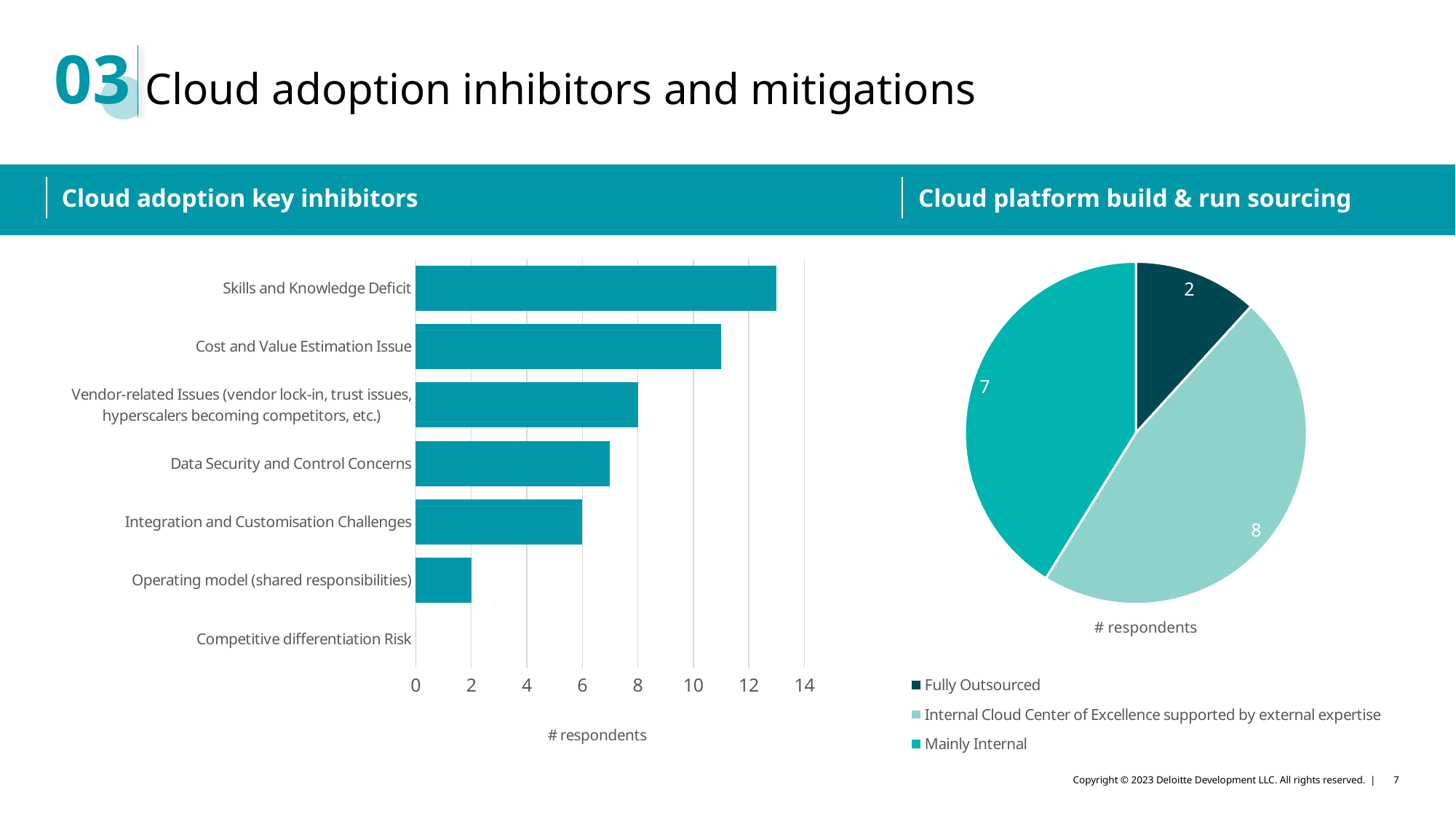
On the Cloud platform build & run sourcing pie chart, how many respondents chose Fully Outsourced? 2 On the Cloud adoption key inhibitors chart, how many respondents cited Operating model (shared responsibilities)? 2 On the Cloud adoption key inhibitors chart, which inhibitor has the highest number of respondents? Skills and Knowledge Deficit On the Cloud adoption key inhibitors chart, how many respondents cited Vendor-related Issues? 8 What type of chart is the Cloud adoption key inhibitors chart? Bar chart On the Cloud platform build & run sourcing pie chart, what is the difference in respondents between Internal Cloud Center of Excellence supported by external expertise and Mainly Internal? 1 On the Cloud adoption key inhibitors chart, is the value for Skills and Knowledge Deficit greater or less than 12? greater On the Cloud platform build & run sourcing pie chart, which sourcing option has the most respondents? Internal Cloud Center of Excellence supported by external expertise On the Cloud adoption key inhibitors chart, how many respondents cited Integration and Customisation Challenges? 6 On the Cloud adoption key inhibitors chart, is the value for Cost and Value Estimation Issue greater or less than 10? greater On the Cloud adoption key inhibitors chart, which has more respondents: Data Security and Control Concerns or Integration and Customisation Challenges? Data Security and Control Concerns How many inhibitor categories are listed on the Cloud adoption key inhibitors chart? 7